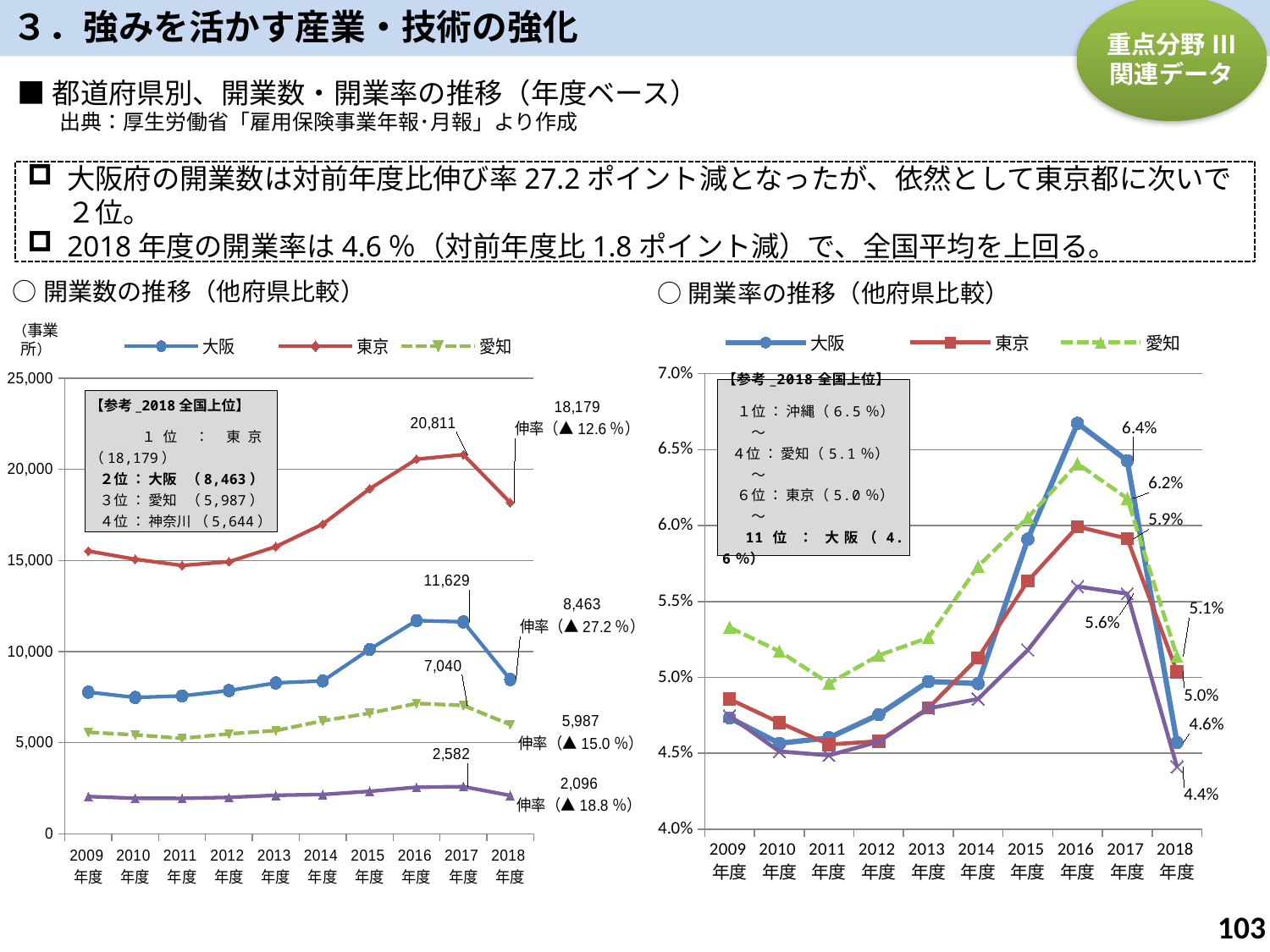
In the left chart (開業数の推移), which series has the highest value in 2018年度? 東京 In the left chart (開業数の推移), what is the value for 愛知 in 2018年度? 5,987 In the right chart (開業率の推移), what is the value for 愛知 in 2018年度? 5.1% In the left chart (開業数の推移), by how much did the 大阪 value fall from 2017年度 (11,629) to 2018年度 (8,463)? 3,166 In the left chart (開業数の推移), what is the value for 大阪 in 2018年度? 8,463 In the left chart (開業数の推移), how many series does the legend list? 3 In the right chart (開業率の推移), what is the value for 大阪 in 2017年度? 6.4% In the left chart (開業数の推移), how many fiscal years are shown on the x axis? 10 What kind of chart is the right chart (開業率の推移)? Line chart In the right chart (開業率の推移), which is larger in 2018年度, the value for 大阪 or the value for 東京? 東京 In the right chart (開業率の推移), is the value for 大阪 in 2016年度 greater or less than 6.5%? greater In the left chart (開業数の推移), what is the value for 東京 in 2017年度? 20,811